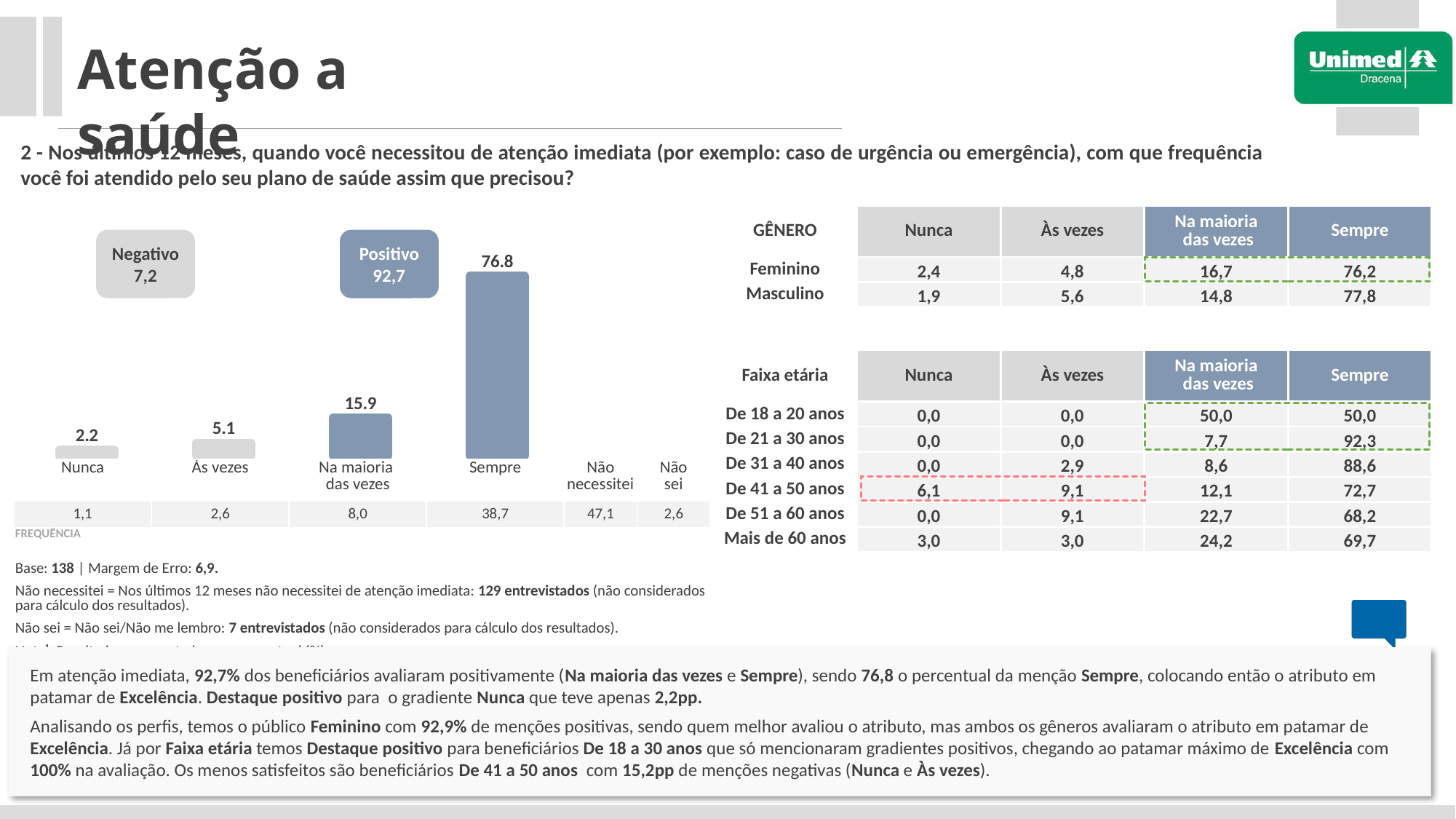
What is the value shown for the 'Às vezes' bar? 5.1 What value is shown in the 'Positivo' box above the chart? 92,7 What is the difference between the 'Na maioria das vezes' bar and the 'Às vezes' bar? 10.8 What is the value shown for the 'Sempre' bar? 76.8 What kind of chart is shown on the slide? bar chart What is the value shown for the 'Na maioria das vezes' bar? 15.9 Do the bar values rise or fall from 'Nunca' to 'Sempre' along the x axis? rise Which category has the highest bar in the chart? Sempre What is the difference between the 'Sempre' bar and the 'Na maioria das vezes' bar? 60.9 Which is larger, the 'Às vezes' bar or the 'Nunca' bar? Às vezes What is the value shown for the 'Nunca' bar? 2.2 Which category has the lowest bar in the chart? Nunca